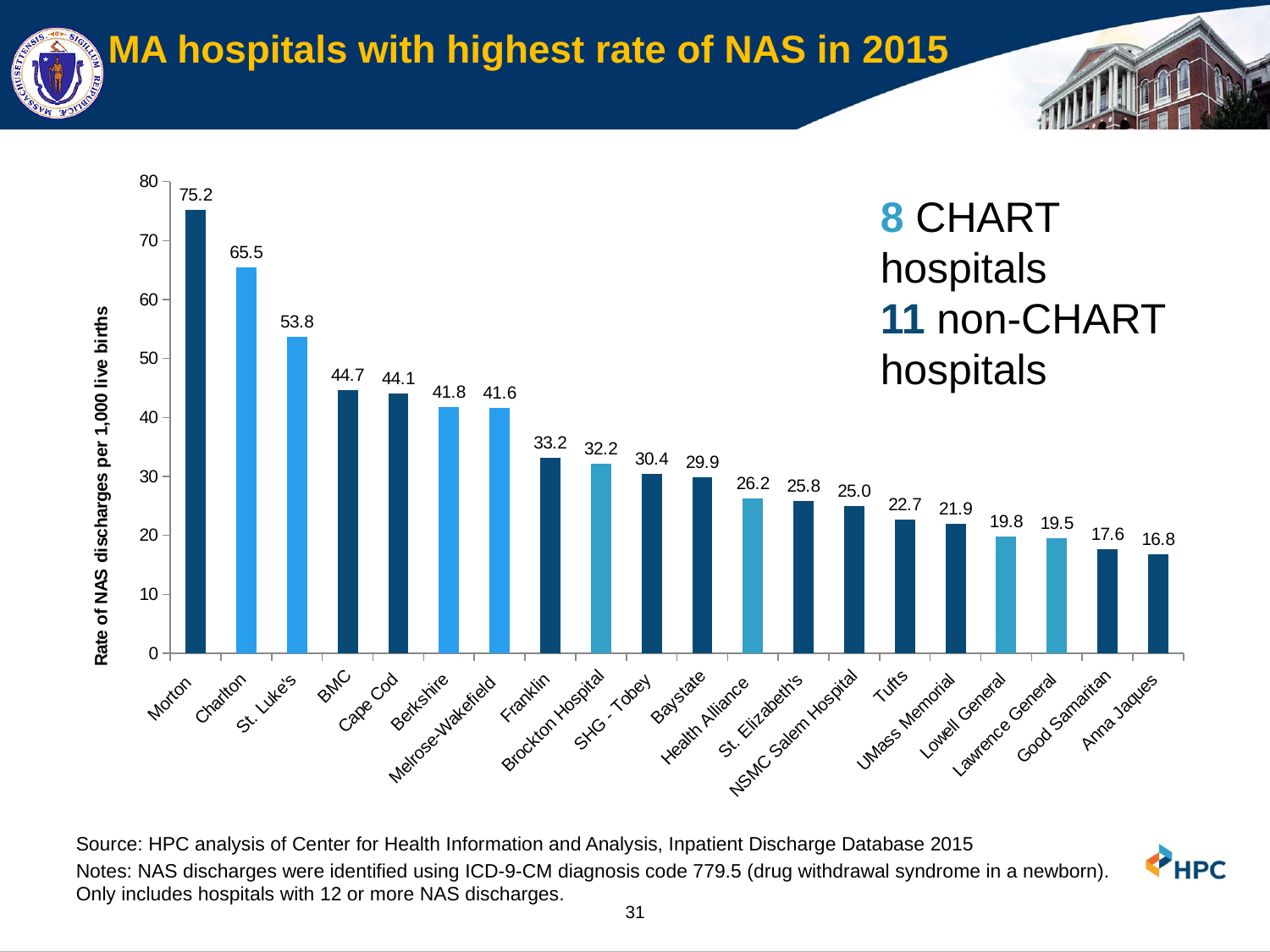
What is the rate of NAS discharges per 1,000 live births for Lowell General? 19.8 Which has a higher NAS rate, Franklin or Tufts? Franklin Which hospital has the lowest rate of NAS discharges? Anna Jaques What is the rate of NAS discharges per 1,000 live births for Baystate? 29.9 Which hospital has the highest rate of NAS discharges? Morton How many hospitals are shown in the chart? 20 What is the rate of NAS discharges per 1,000 live births for Morton? 75.2 Is the value for Tufts greater or less than 20? greater What kind of chart is shown on the slide? Bar chart What is the difference between the NAS rates of Morton and Charlton? 9.7 What is the difference between the NAS rates of Good Samaritan and Anna Jaques? 0.8 Do the values rise or fall moving from left to right along the x axis? Fall